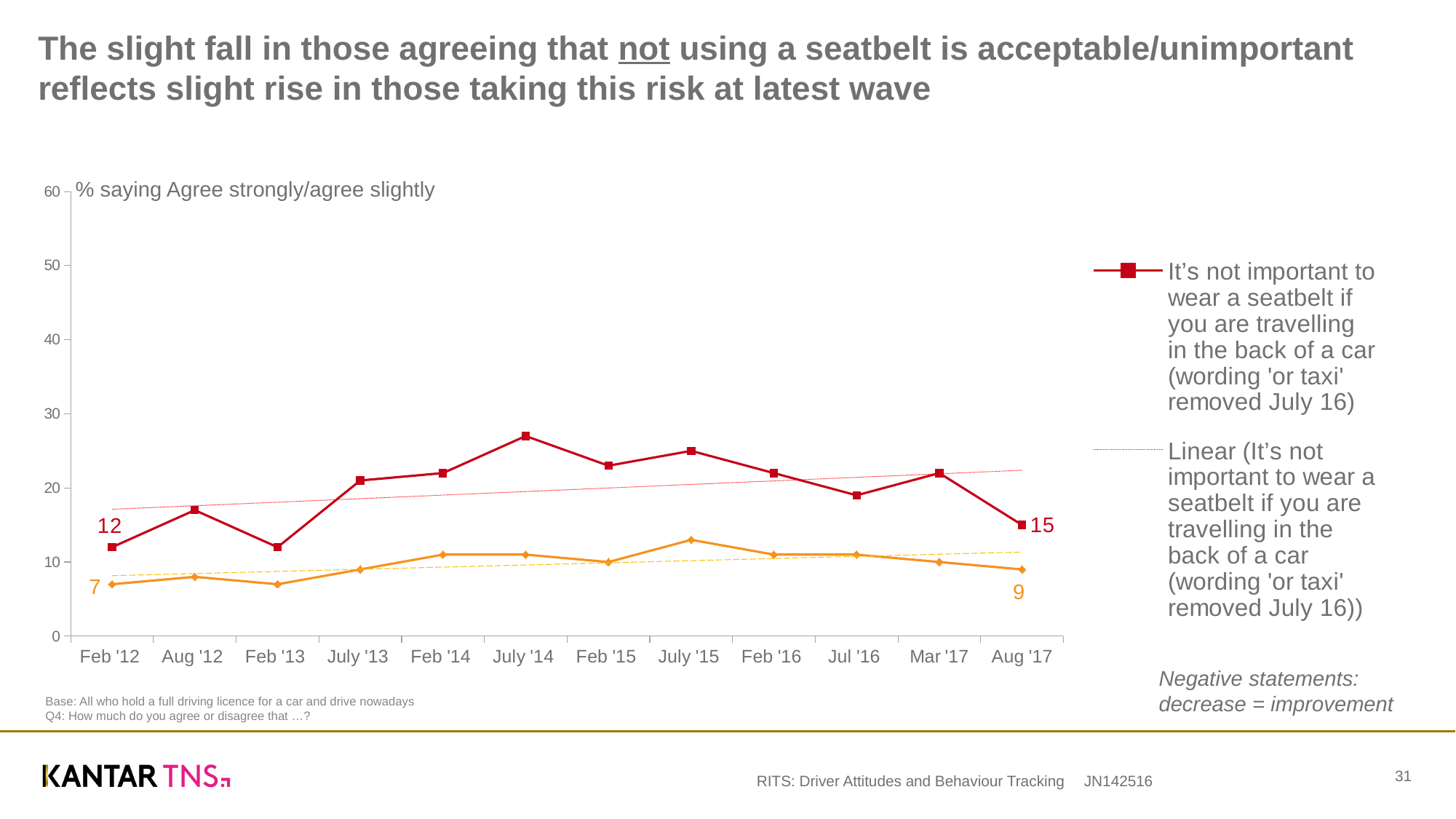
By how much did the red 'It's not important to wear a seatbelt' series change between Feb '12 and Aug '17? 3 Is the value of the red series at July '14 greater or less than 20? greater What is the value of the orange line at Aug '17? 9 At which wave does the red 'It's not important to wear a seatbelt' series reach its highest point? July '14 What is the value of the orange line at Feb '12? 7 What is the value of the 'It's not important to wear a seatbelt if you are travelling in the back of a car' series at Aug '17? 15 How many waves (x-axis points) are shown on the chart? 12 What is the value of the 'It's not important to wear a seatbelt if you are travelling in the back of a car' series at Feb '12? 12 What type of chart is shown on the slide? Line chart What is the difference between the red series and the orange line at Aug '17? 6 At Feb '12, which is larger: the red 'It's not important to wear a seatbelt' series or the orange line? The red 'It's not important to wear a seatbelt' series How many entries does the legend list? 2